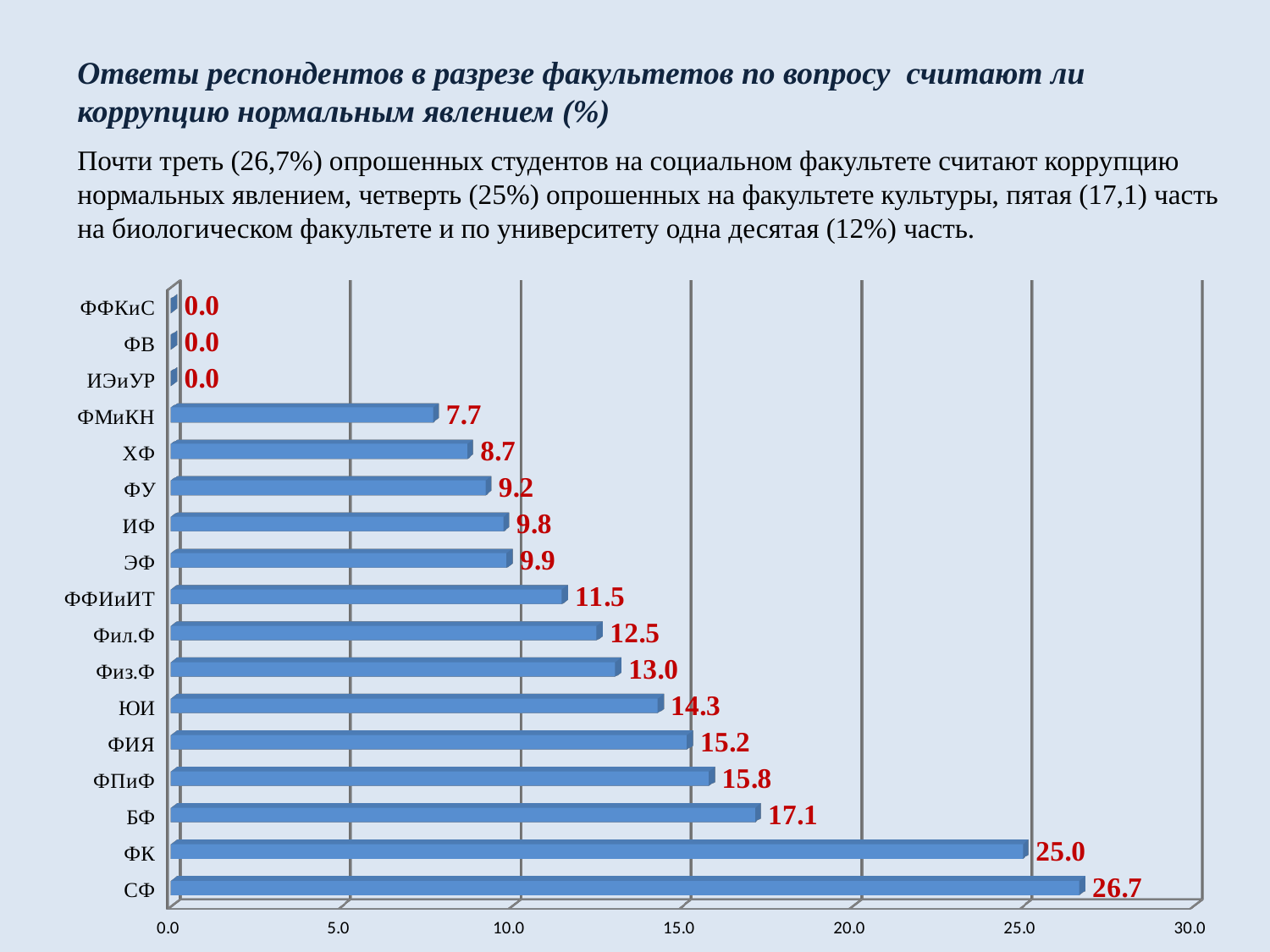
What is the difference between the values for ФПиФ and ФИЯ? 0.6 How many faculties have a value of 0.0? 3 What is the value for СФ? 26.7 Which faculty has the highest value? СФ Is the value for ФК greater or less than 20.0? greater What is the value for ФМиКН? 7.7 What is the value for БФ? 17.1 What is the difference between the values for СФ and ФК? 1.7 How many faculties are shown in the chart? 17 Which is larger, the value for ХФ or the value for ФУ? ФУ What is the value for ЮИ? 14.3 What kind of chart is shown on the slide? Bar chart